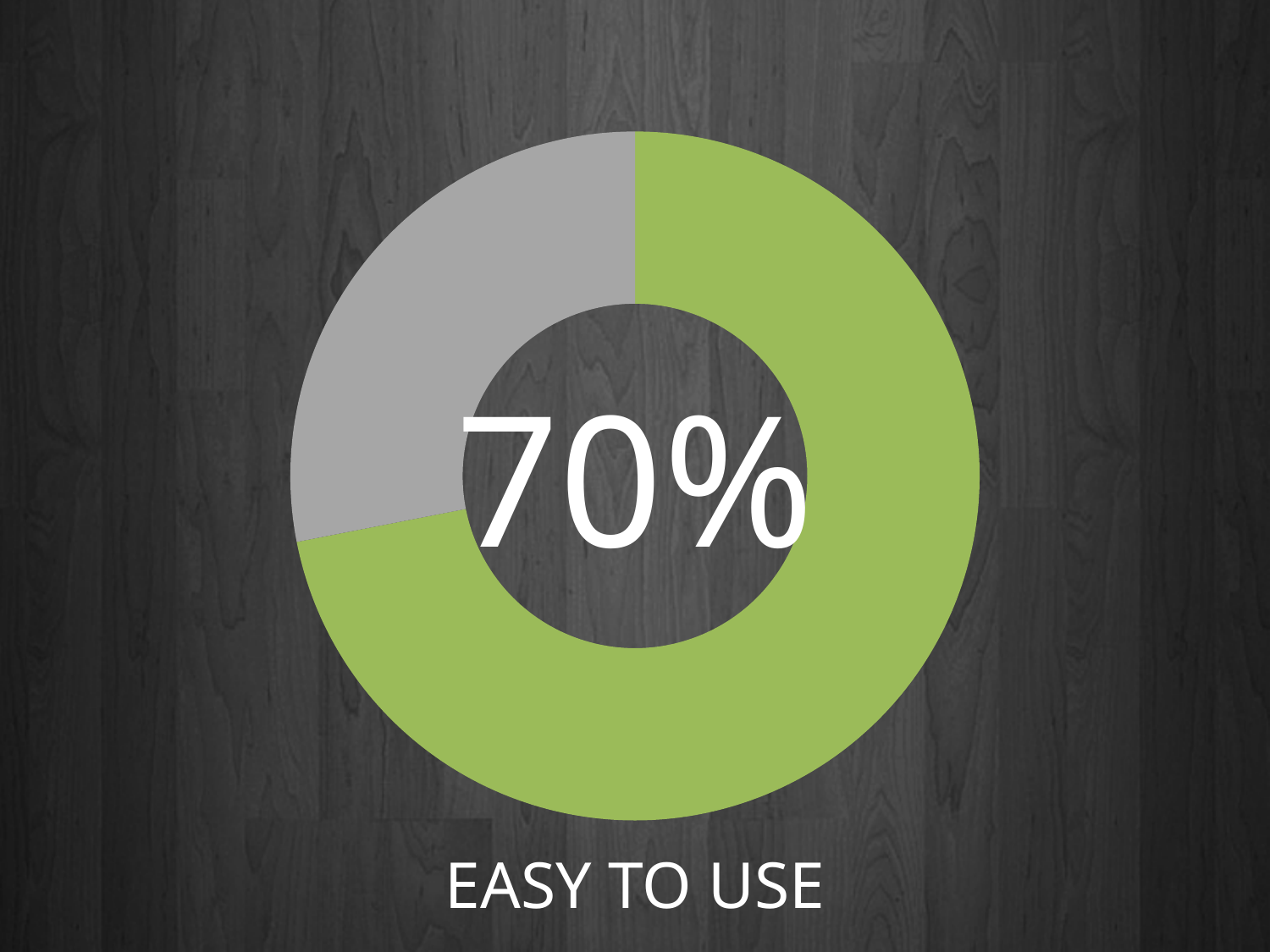
How many segments does the doughnut chart have? 2 Is the grey segment of the doughnut chart greater or less than 50%? less Is the green segment of the doughnut chart greater or less than 50%? greater What share of the doughnut chart does the green segment represent? 70% What percentage is printed in the centre of the doughnut chart? 70% What is the caption below the doughnut chart? EASY TO USE What colour is the segment representing the 70% value in the doughnut chart? green What kind of chart is shown on the slide? doughnut chart Which segment of the doughnut chart is larger, the green one or the grey one? green